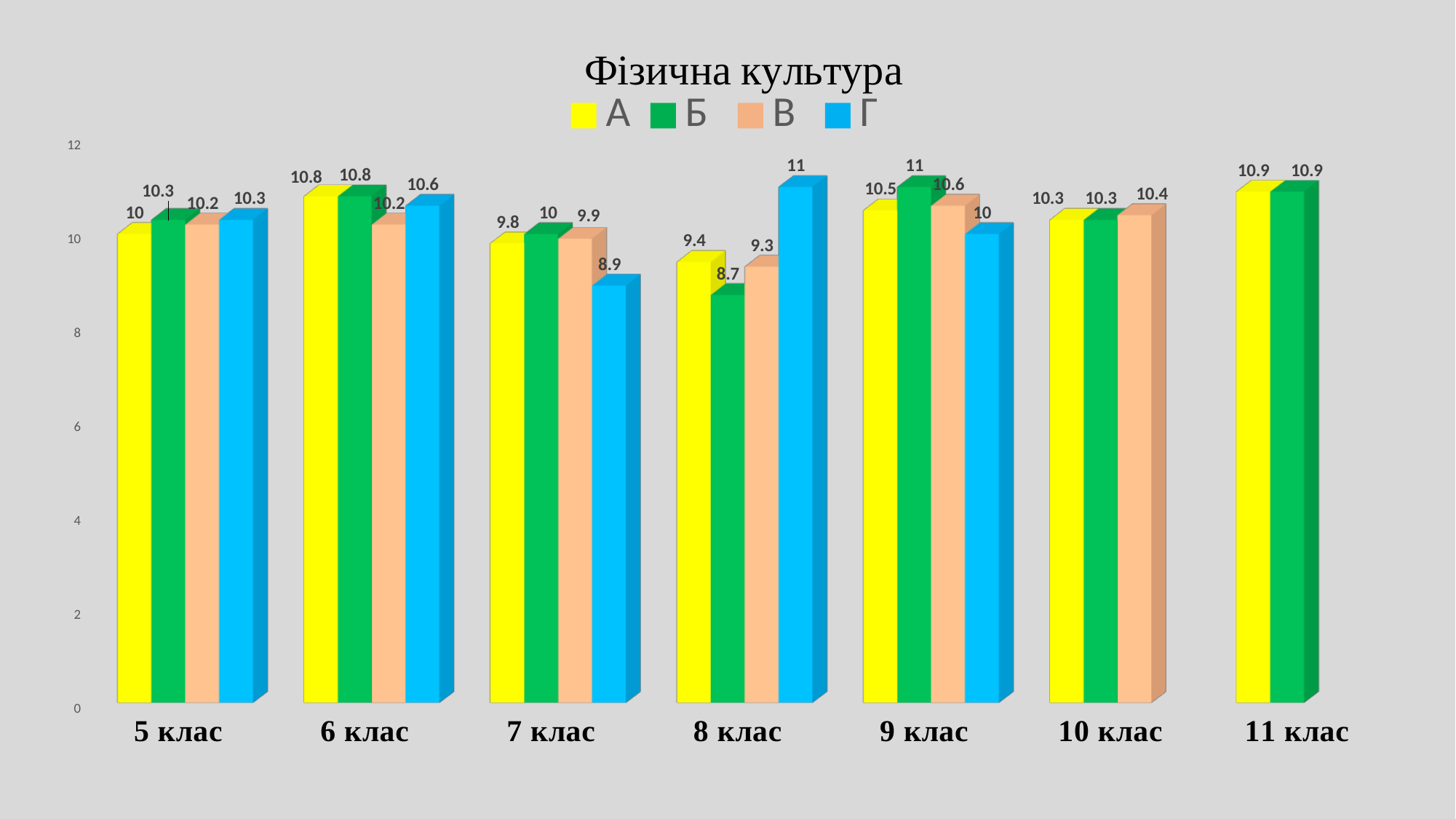
What kind of chart is shown? bar chart How many series does the legend list? 4 What is the value for series Б in 7 клас? 10 Which category has the highest value for series Б? 9 клас What is the title of the chart? Фізична культура What is the value for series В in 10 клас? 10.4 Which category has the lowest value for series Г? 7 клас What is the difference between series Г and series Б in 8 клас? 2.3 What is the value for series Г in 8 клас? 11 How many categories are shown on the x axis? 7 Is the value for series Б in 8 клас greater or less than 10? less Which is larger in 9 клас: series А or series В? В